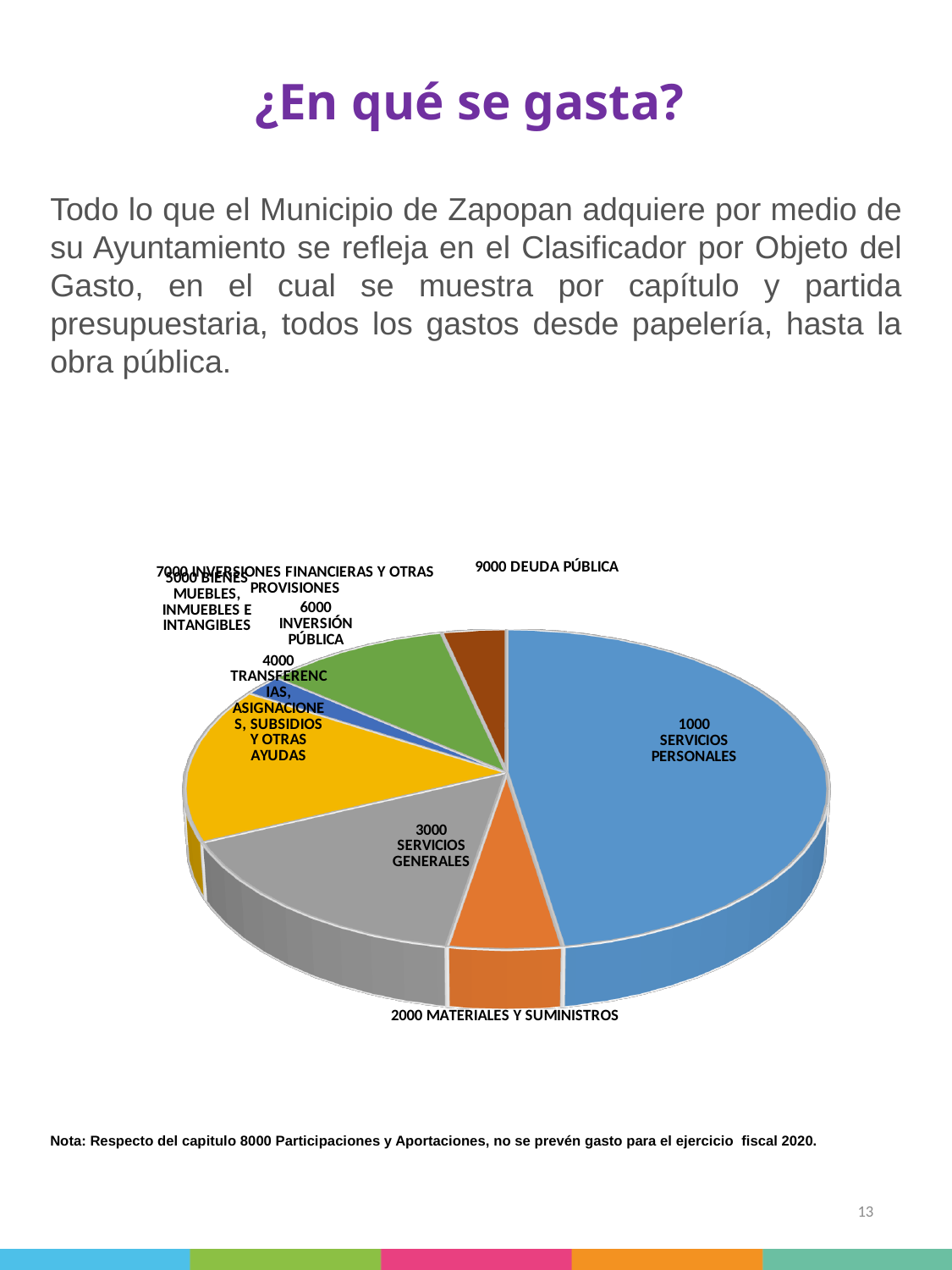
What colour is the 3000 SERVICIOS GENERALES slice? gray Which slice is larger, 3000 SERVICIOS GENERALES or 2000 MATERIALES Y SUMINISTROS? 3000 SERVICIOS GENERALES Which slice is larger, 6000 INVERSIÓN PÚBLICA or 9000 DEUDA PÚBLICA? 6000 INVERSIÓN PÚBLICA Which slice is larger, 1000 SERVICIOS PERSONALES or 3000 SERVICIOS GENERALES? 1000 SERVICIOS PERSONALES What kind of chart is shown on the slide? pie chart How many slices does the pie chart have? 8 Which category has the largest slice of the pie chart? 1000 SERVICIOS PERSONALES What colour is the 1000 SERVICIOS PERSONALES slice? blue